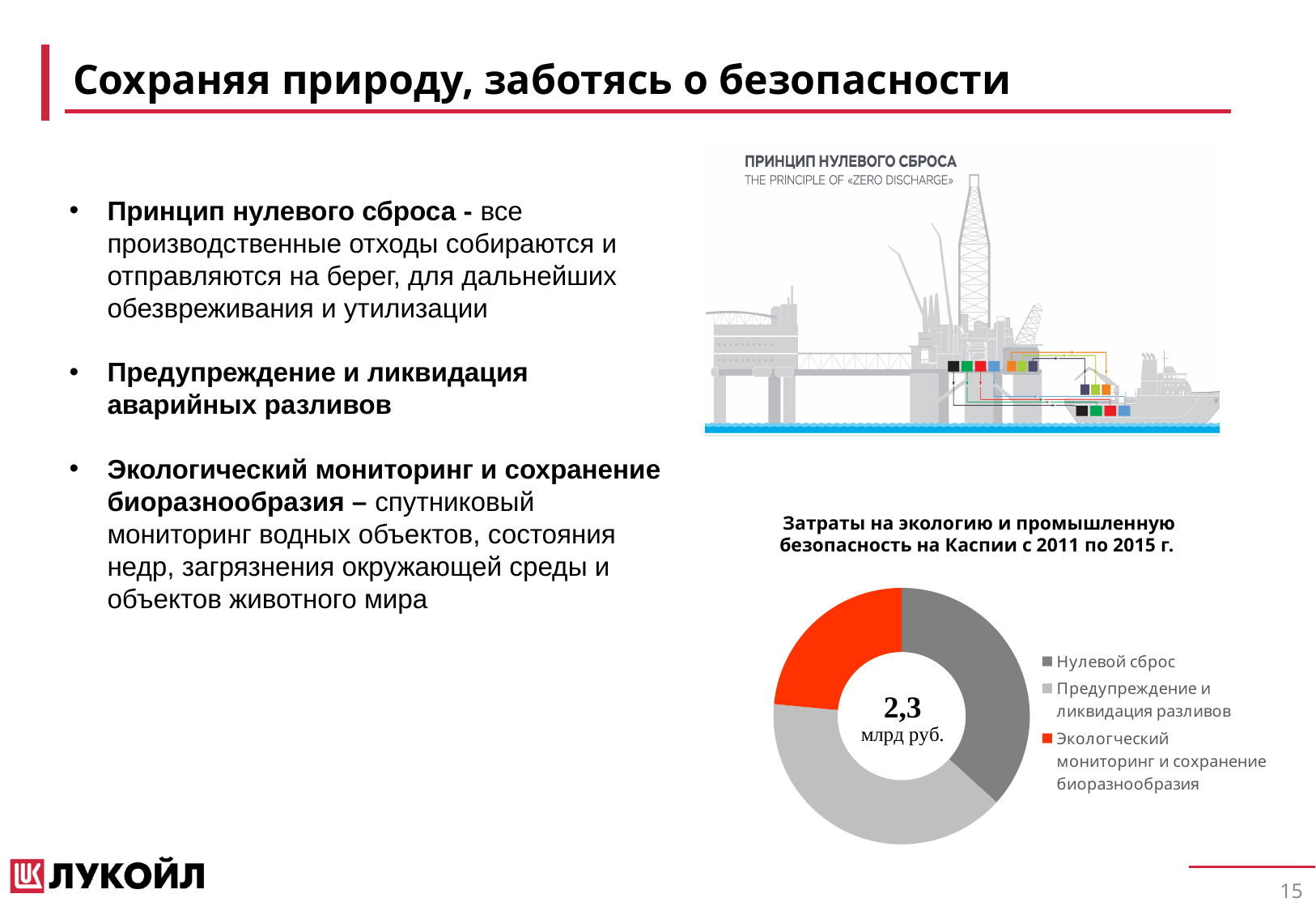
How many categories does the donut chart show? 3 How many entries does the legend of the donut chart list? 3 Which slice is larger: Нулевой сброс or Экологический мониторинг и сохранение биоразнообразия? Нулевой сброс What is the title of the donut chart? Затраты на экологию и промышленную безопасность на Каспии с 2011 по 2015 г. Which slice is larger: Предупреждение и ликвидация разливов or Экологический мониторинг и сохранение биоразнообразия? Предупреждение и ликвидация разливов What kind of chart is shown on the slide? Pie chart (donut) What total value is printed in the centre of the donut chart? 2,3 млрд руб. Which category has the smallest slice in the donut chart? Экологический мониторинг и сохранение биоразнообразия